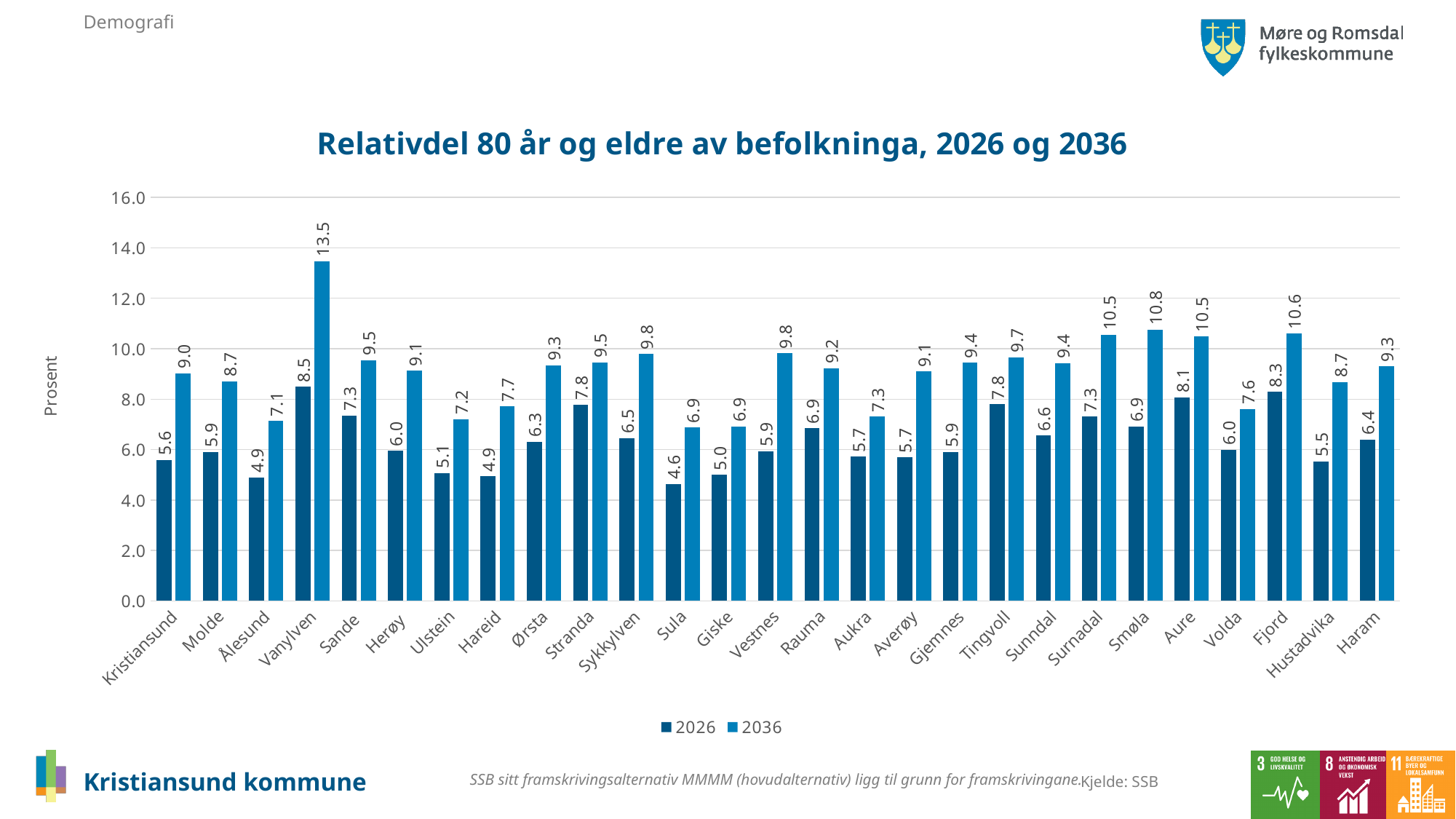
Which is larger, the 2026 value for Fjord or the 2026 value for Volda? Fjord What is the 2026 value for Kristiansund? 5.6 What is the 2036 value for Vanylven? 13.5 What is the difference between the 2036 and 2026 values for Kristiansund? 3.4 How many series does the legend list? 2 What is the 2036 value for Hustadvika? 8.7 How many municipalities are shown on the x axis? 27 What kind of chart is shown on the slide? Bar chart Which municipality has the highest 2036 value? Vanylven What is the title of the chart? Relativdel 80 år og eldre av befolkninga, 2026 og 2036 Is the 2036 value for Smøla greater or less than 10.0? greater Which municipality has the lowest 2026 value? Sula